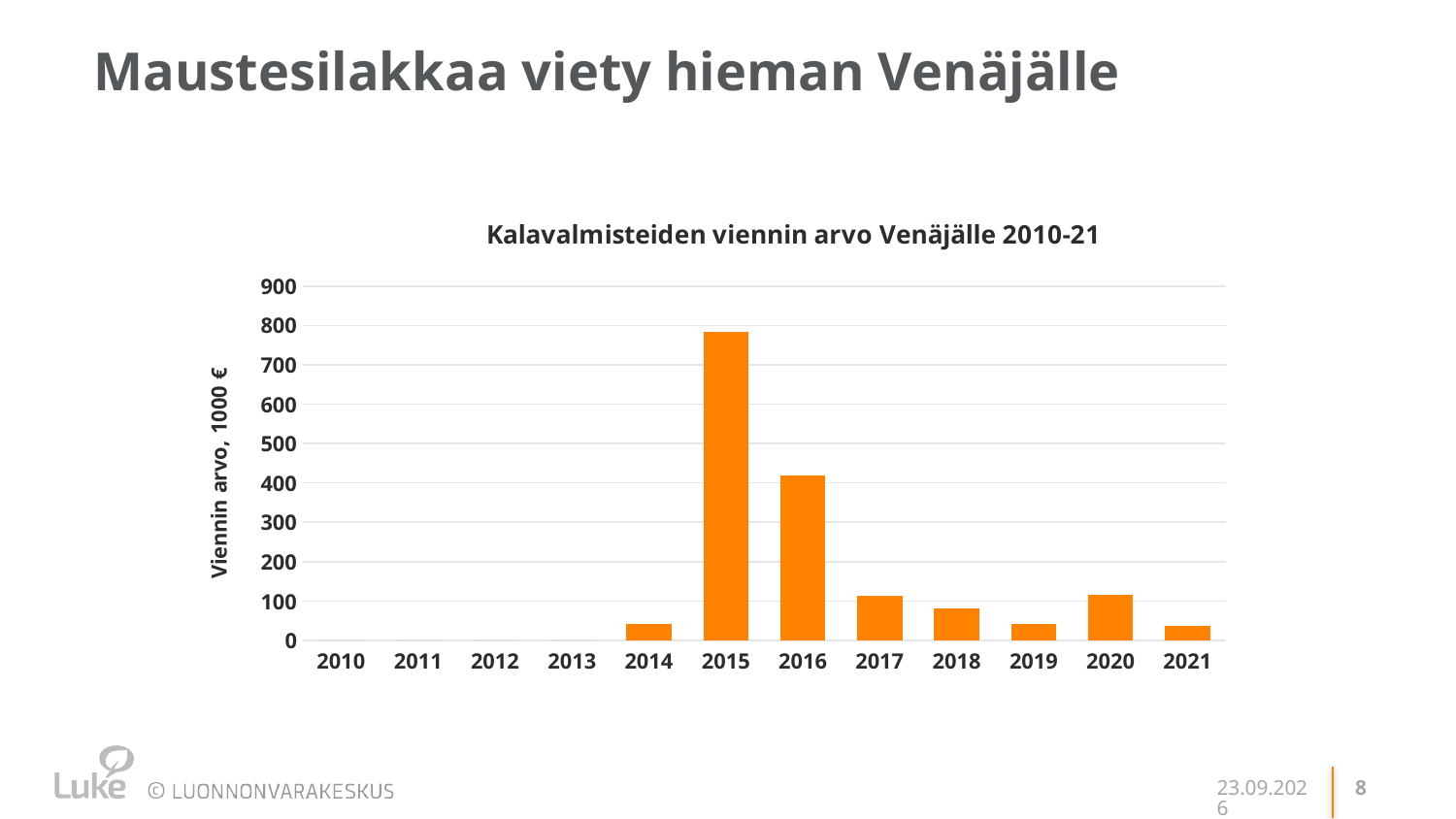
Is the value for 2015 greater or less than 700? greater What is the title of the chart? Kalavalmisteiden viennin arvo Venäjälle 2010-21 Is the value for 2016 greater or less than 300? greater How many years are shown on the x axis of the chart? 12 Which year has the larger value, 2015 or 2016? 2015 Is the value for 2016 greater or less than 500? less What is the label of the vertical axis? Viennin arvo, 1000 € What kind of chart is shown on the slide? bar chart Which year has the larger value, 2016 or 2017? 2016 Which year has the highest export value in the chart? 2015